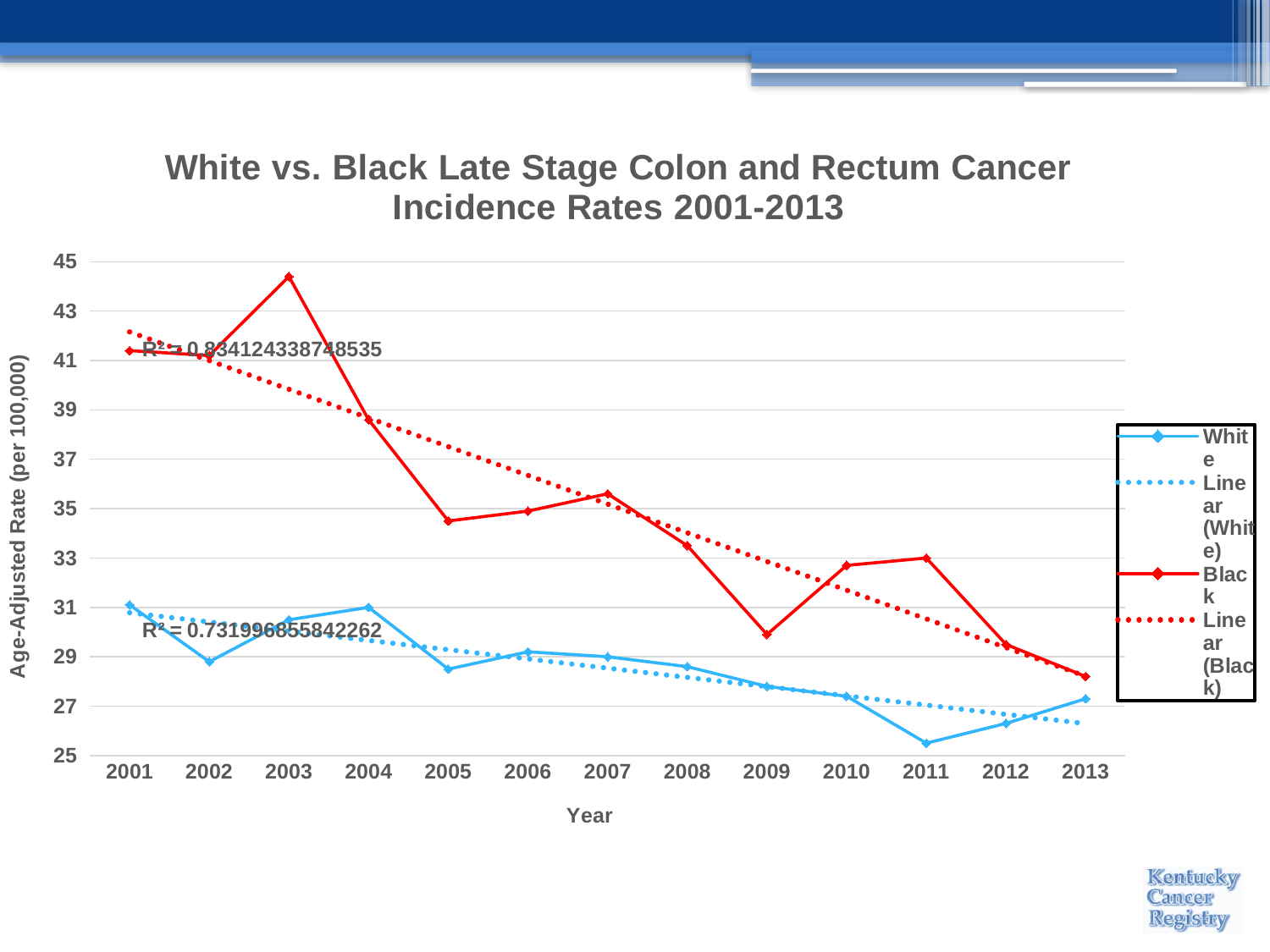
Is the value for White in 2011 greater or less than 27? less What kind of chart is shown on the slide? line chart Is the value for Black in 2009 greater or less than 31? less How many years are plotted along the x axis? 13 In which year does the Black series reach its highest value? 2003 In which year does the White series reach its lowest value? 2011 Is the value for Black in 2003 greater or less than 43? greater What R² value is shown for the Black trendline? 0.834124338748535 In which year does the Black series reach its lowest value? 2013 How many entries does the legend list? 4 In 2001, which series has the higher value, White or Black? Black Do the Black series values generally rise or fall from 2001 to 2013? fall